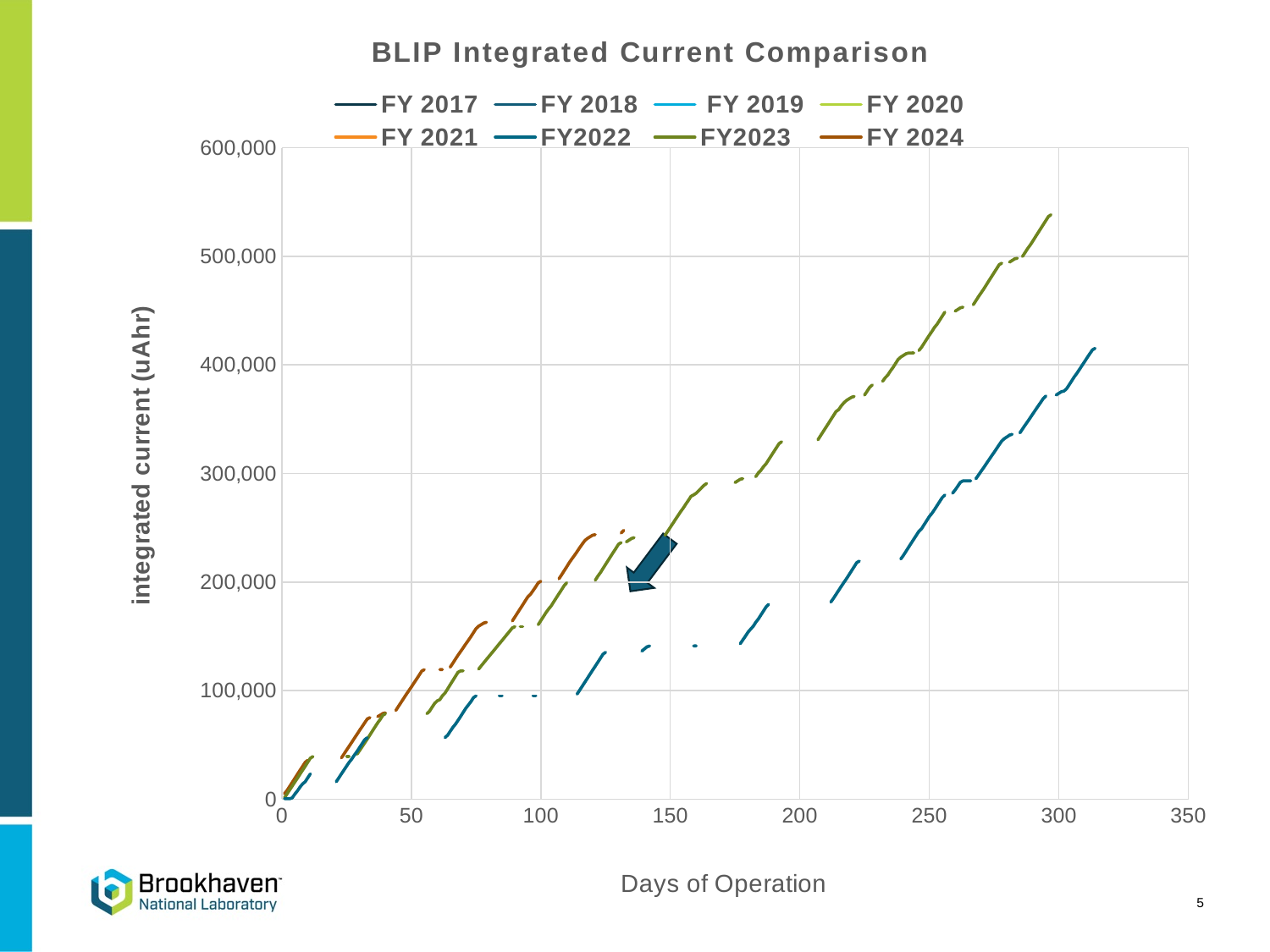
Which series reaches a higher integrated current, FY2023 or FY2022? FY2023 What is the title of the chart? BLIP Integrated Current Comparison Which series reaches the highest integrated current on the chart? FY2023 Is the value of the FY2023 line at 200 days of operation greater or less than 300,000? greater What kind of chart is shown on the slide? line chart What is the label of the vertical axis? integrated current (uAhr) Is the value of the FY2022 line at 300 days of operation greater or less than 400,000? less Is the highest value reached by the FY2023 line greater or less than 500,000? greater Do the integrated current values rise or fall as days of operation increase? rise How many series does the legend list? 8